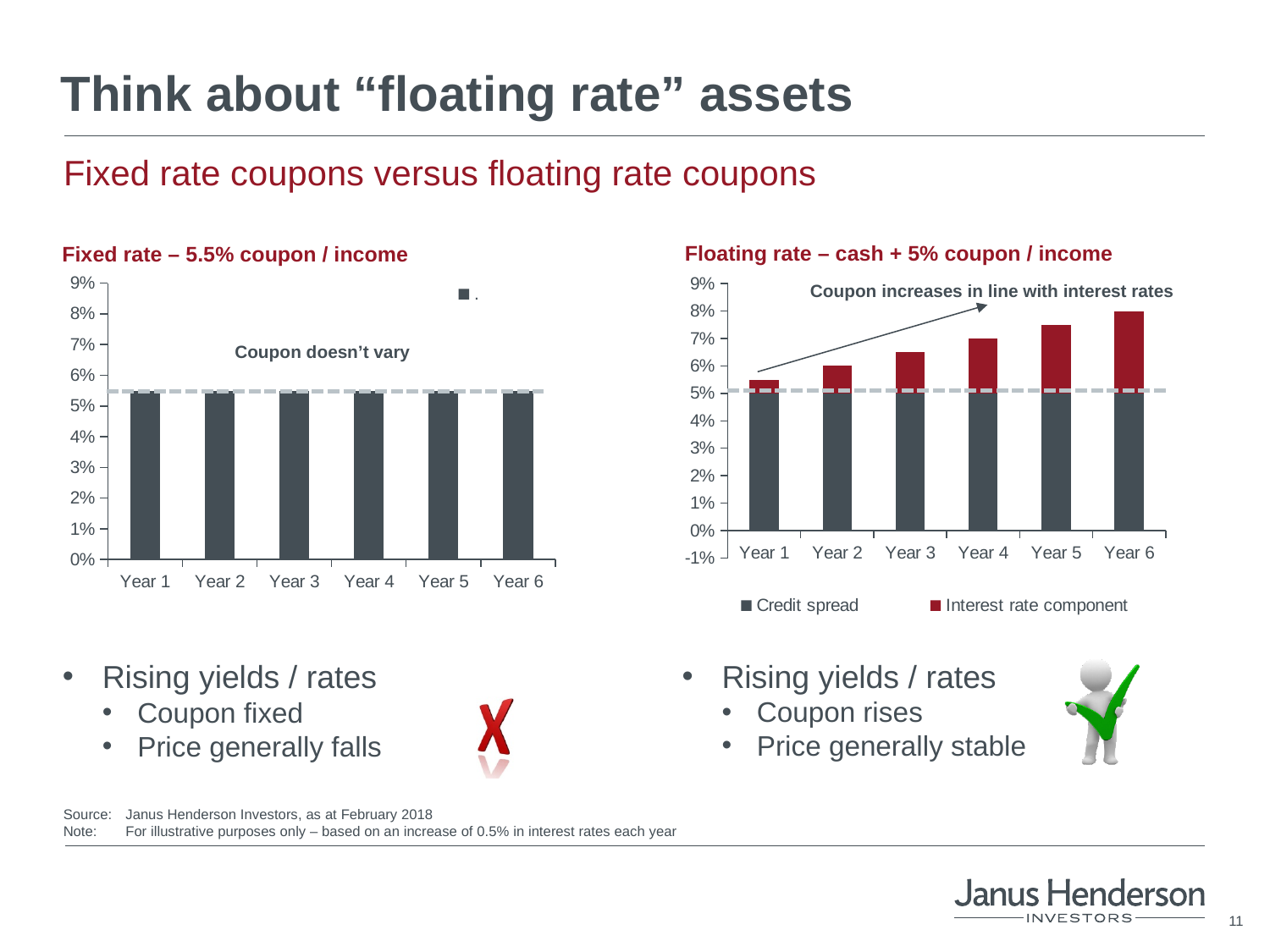
On the 'Floating rate – cash + 5% coupon / income' chart, which series is shown in red? Interest rate component On the 'Floating rate – cash + 5% coupon / income' chart, what is the total height of the Year 6 bar? 8% On the 'Floating rate – cash + 5% coupon / income' chart, how many series does the legend list? 2 On the 'Fixed rate – 5.5% coupon / income' chart, is the value for Year 6 greater or less than 6%? less On the 'Floating rate – cash + 5% coupon / income' chart, which year has the lowest total bar? Year 1 On the 'Floating rate – cash + 5% coupon / income' chart, what is the Credit spread value for Year 1? 5% On the 'Fixed rate – 5.5% coupon / income' chart, how many years are shown on the x axis? 6 On the 'Fixed rate – 5.5% coupon / income' chart, is the value for Year 3 greater or less than 5%? greater On the 'Floating rate – cash + 5% coupon / income' chart, is the total for Year 5 greater or less than 7%? greater What kind of chart is the 'Floating rate – cash + 5% coupon / income' chart? Stacked bar chart On the 'Floating rate – cash + 5% coupon / income' chart, do the total bar heights rise or fall from Year 1 to Year 6? Rise On the 'Floating rate – cash + 5% coupon / income' chart, which year has the highest total bar? Year 6